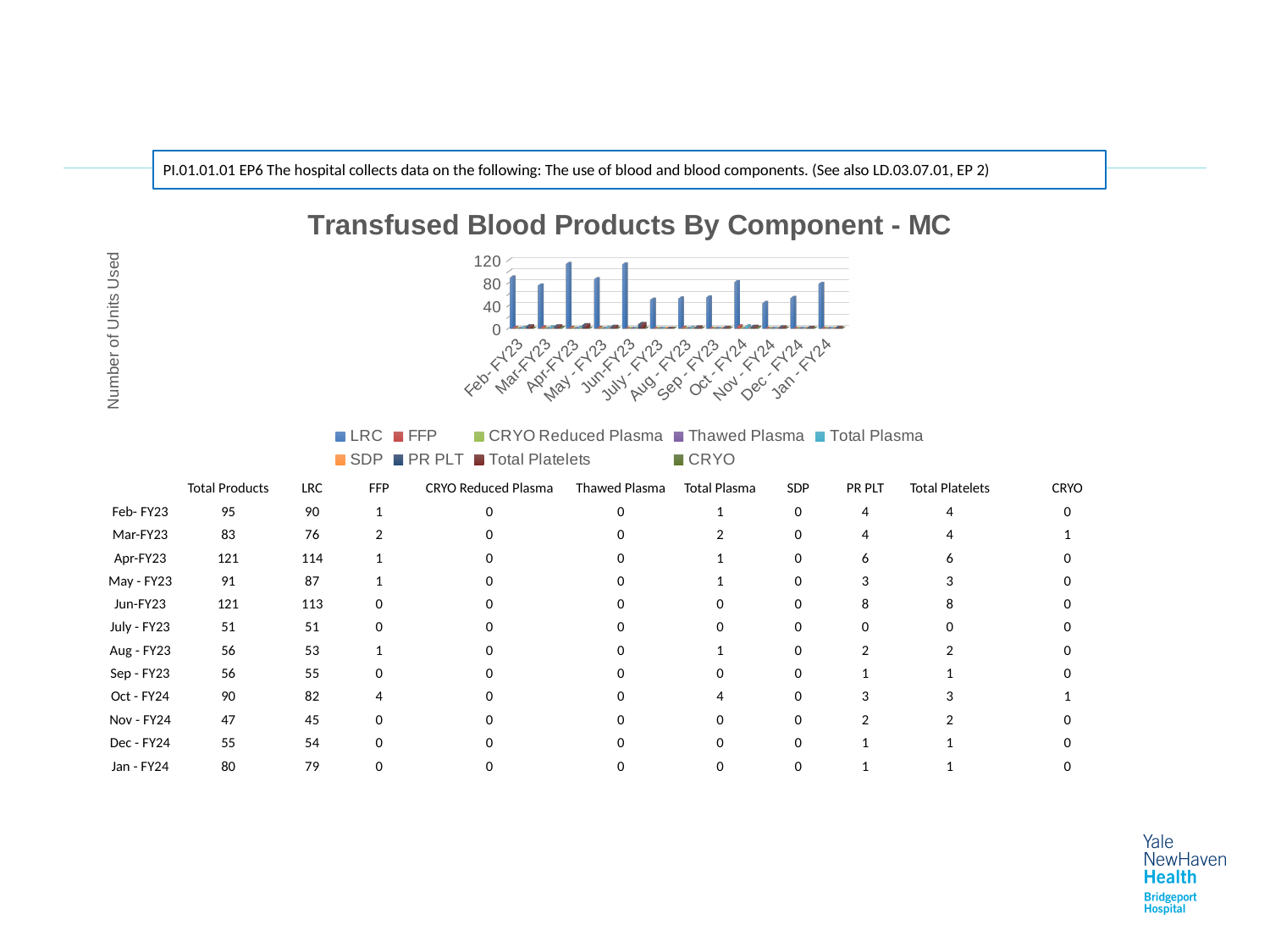
Which month has the highest LRC value? Apr-FY23 What is the title of the chart? Transfused Blood Products By Component - MC What type of chart is shown on the slide? bar chart What is the FFP value for Oct - FY24? 4 Which is larger, the LRC value for Oct - FY24 or for Jan - FY24? Oct - FY24 Which month has the lowest LRC value? Nov - FY24 How many series does the chart legend list? 9 How many months are shown along the x axis of the chart? 12 What is the PR PLT value for Jun-FY23? 8 What is the LRC value for Apr-FY23? 114 What is the difference between the LRC values for Feb- FY23 and Mar-FY23? 14 Is the LRC value for Jun-FY23 greater or less than 80? greater